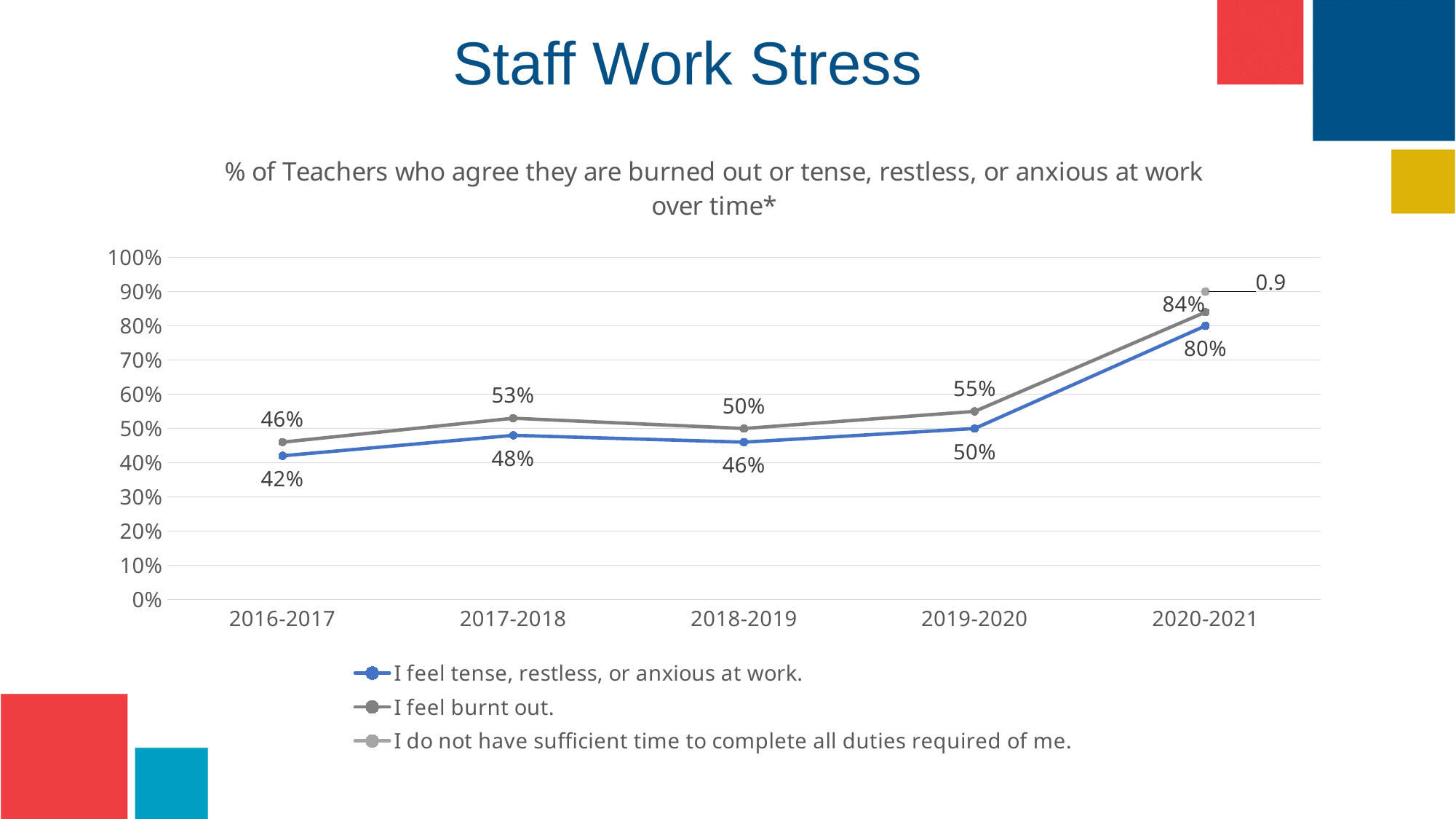
What is the difference between 'I feel burnt out.' and 'I feel tense, restless, or anxious at work.' in 2019-2020? 5% How many school years are shown on the x axis? 5 What kind of chart is shown on the slide? line chart In which school year is 'I feel tense, restless, or anxious at work.' lowest? 2016-2017 What is the data label shown for 'I do not have sufficient time to complete all duties required of me.' in 2020-2021? 0.9 What is the value for 'I feel tense, restless, or anxious at work.' in 2020-2021? 80% What is the value for 'I feel tense, restless, or anxious at work.' in 2016-2017? 42% Which is larger in 2018-2019: 'I feel burnt out.' or 'I feel tense, restless, or anxious at work.'? I feel burnt out. Does 'I feel burnt out.' rise or fall from 2019-2020 to 2020-2021? rise How many series does the legend list? 3 What is the value for 'I feel burnt out.' in 2017-2018? 53% In which school year is 'I feel burnt out.' highest? 2020-2021